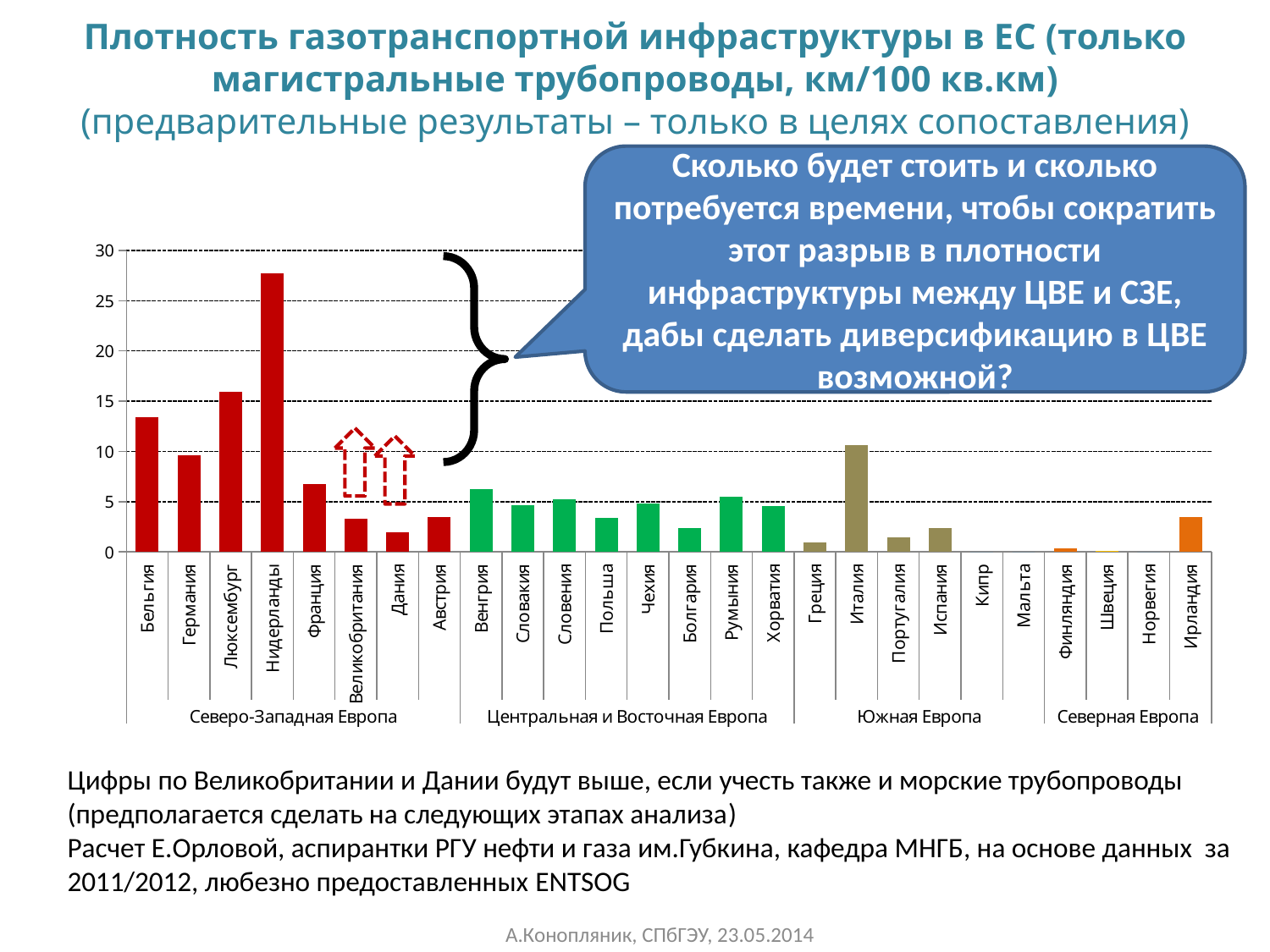
Is the value for Бельгия greater or less than 10? greater What kind of chart is shown on the slide? bar chart Which is larger, the value for Италия or the value for Греция? Италия Is the value for Нидерланды greater or less than 25? greater How many regional groups are the countries divided into along the x axis? 4 Is the value for Дания greater or less than 5? less How many countries are shown on the x axis of the chart? 26 Which country has the highest value in the chart? Нидерланды Which is larger, the value for Люксембург or the value for Бельгия? Люксембург